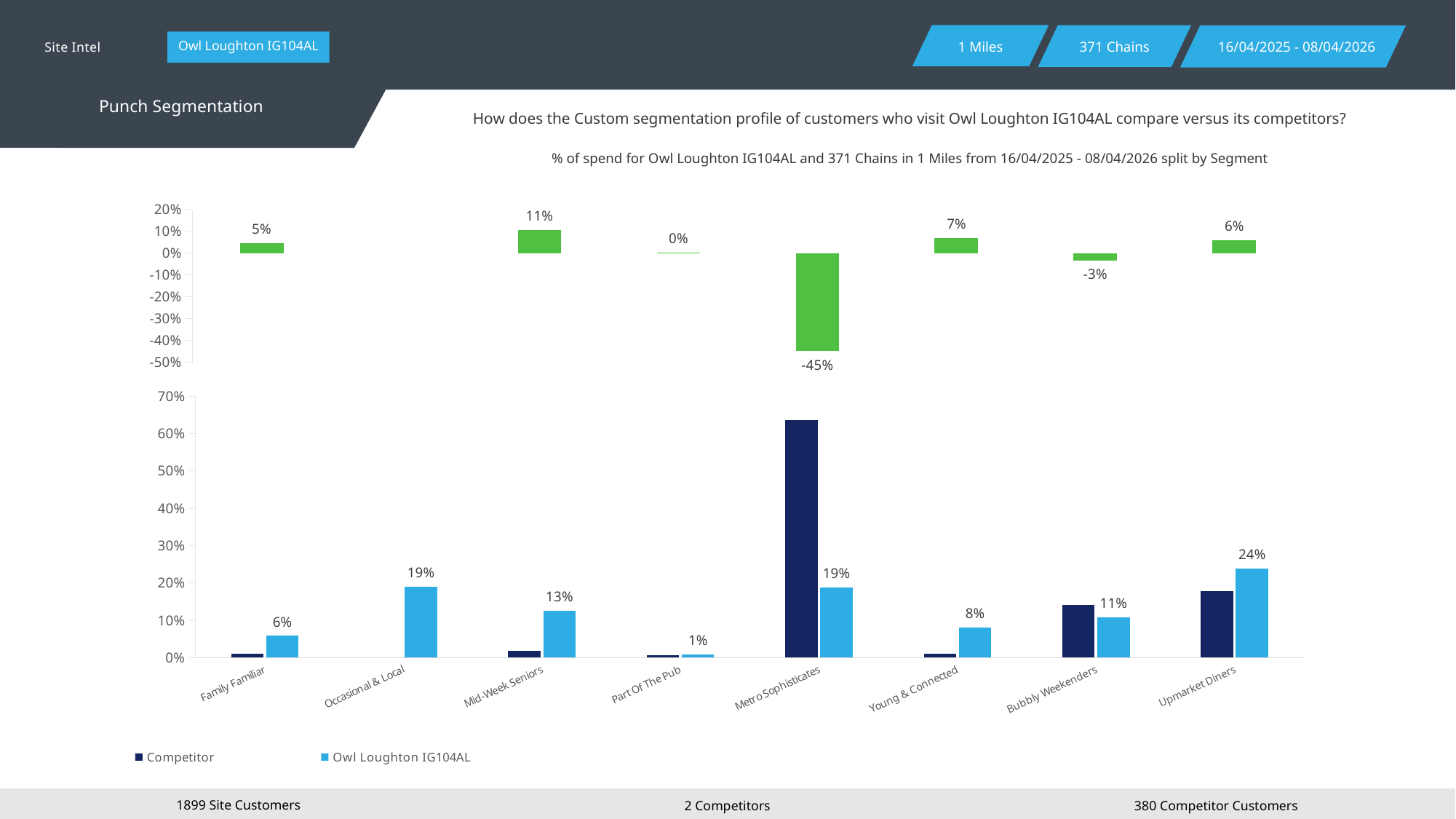
In the top chart, which segment has the lowest value? Metro Sophisticates In the bottom chart, what is the difference between the Owl Loughton IG104AL values for Upmarket Diners and Occasional & Local? 5 percentage points In the top chart, what is the value for Young & Connected? 7% In the bottom chart, is the Competitor value for Metro Sophisticates greater or less than 60%? greater In the top chart, what is the value for Metro Sophisticates? -45% What kind of chart is the bottom chart? bar chart How many series does the legend of the bottom chart list? 2 In the bottom chart, what is the value for Owl Loughton IG104AL in the Upmarket Diners segment? 24% In the bottom chart, which segment has the lowest value for Owl Loughton IG104AL? Part Of The Pub In the bottom chart, which segment has the highest value for Owl Loughton IG104AL? Upmarket Diners How many segments are shown on the x axis of the bottom chart? 8 In the bottom chart, is the Competitor value for Upmarket Diners greater or less than 10%? greater